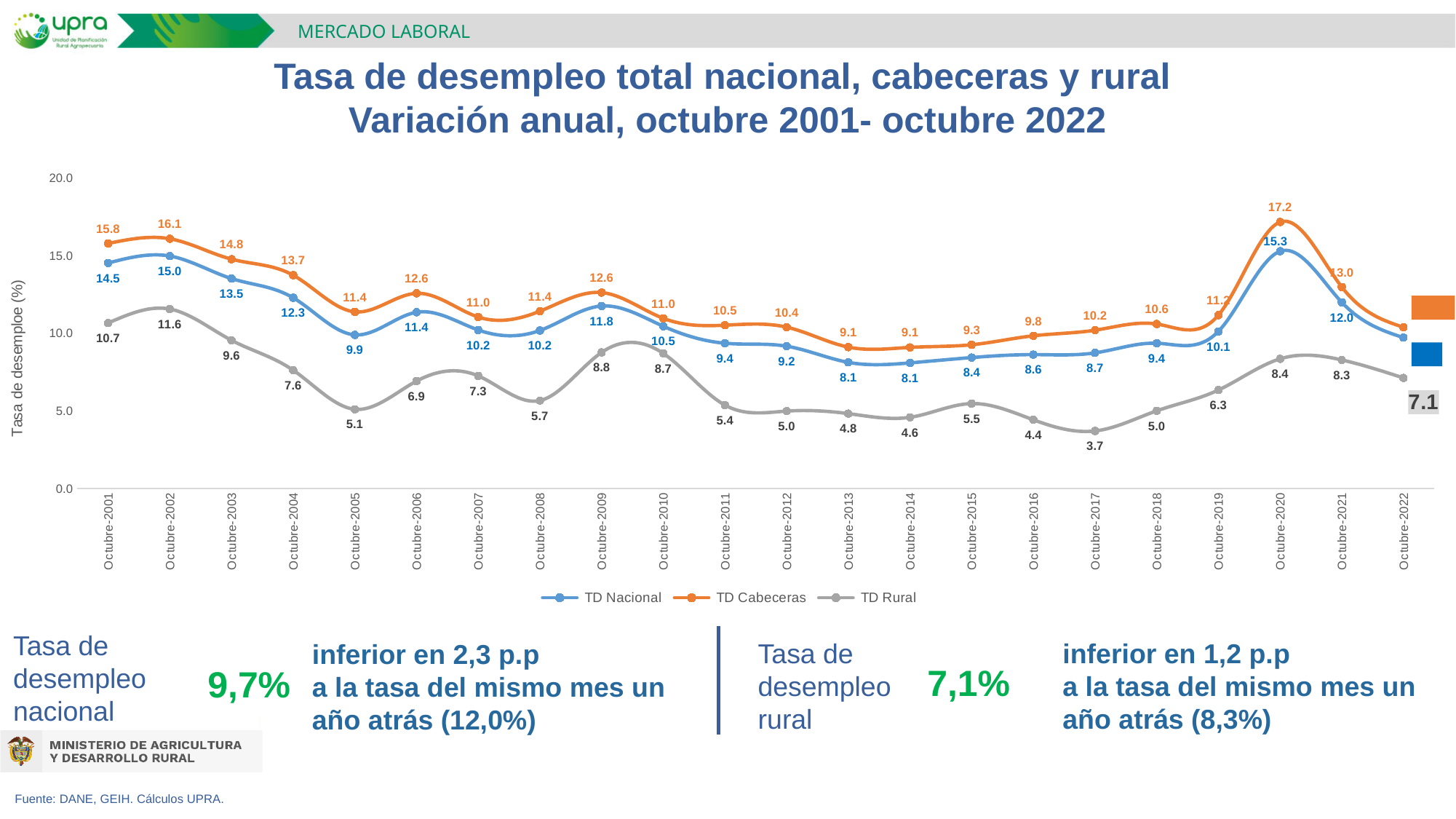
In which month does TD Cabeceras reach its highest value? Octubre-2020 What is the value of TD Cabeceras in Octubre-2020? 17.2 How many series does the legend list? 3 What is the value of TD Rural in Octubre-2022? 7.1 What is the difference between TD Cabeceras and TD Nacional in Octubre-2020? 1.9 What is the value of TD Nacional in Octubre-2013? 8.1 In which month is TD Rural at its lowest? Octubre-2017 Is the value of TD Cabeceras in Octubre-2022 greater or less than 15.0? less What kind of chart is shown on the slide? Line chart In which month is TD Rural at its highest? Octubre-2002 How many points (months) are plotted along the x axis? 22 Which is larger for TD Nacional: Octubre-2002 or Octubre-2009? Octubre-2002